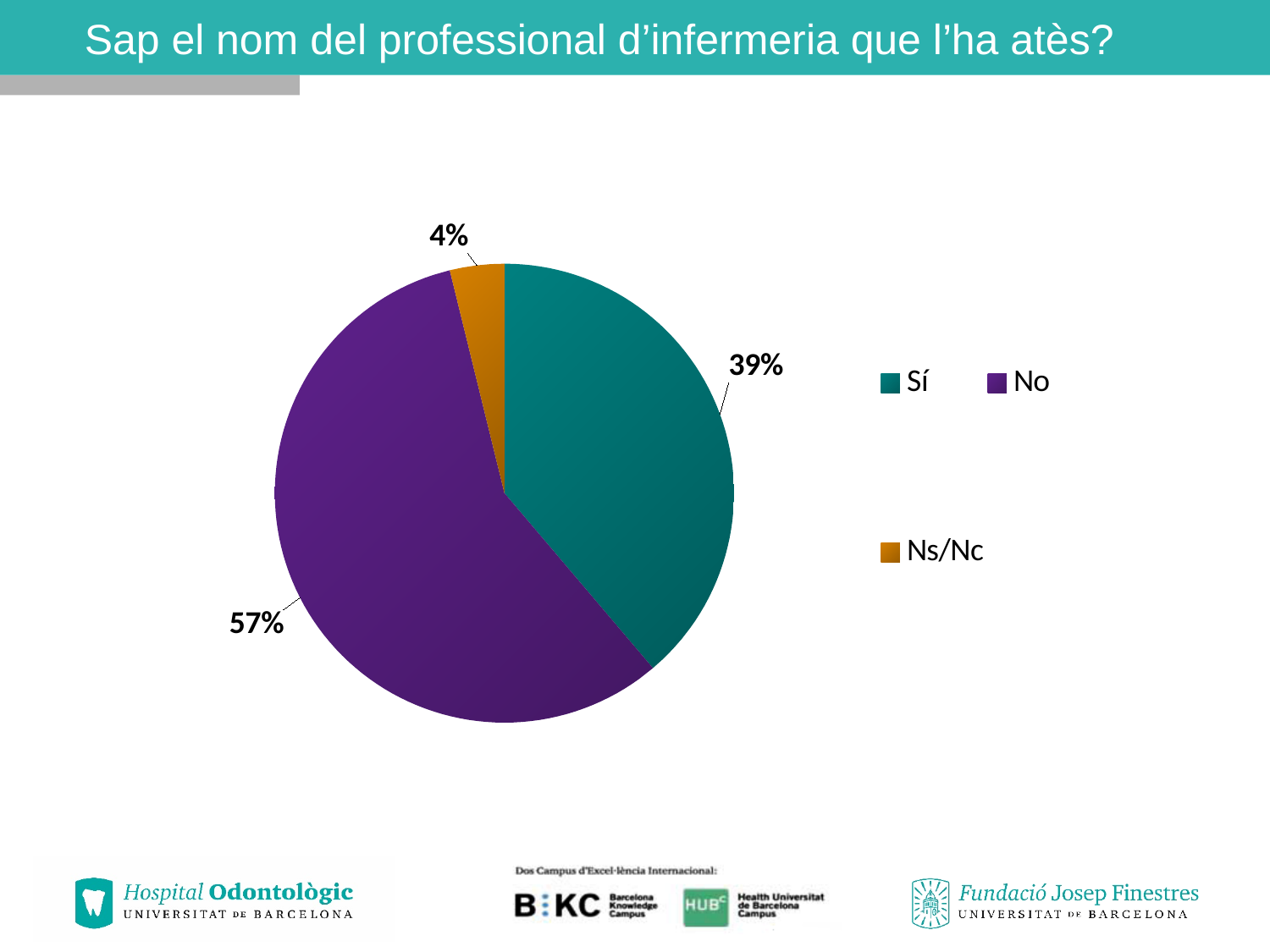
Which is larger, the share for "Sí" or the share for "No"? No What percentage of respondents answered "No"? 57% What colour is the "Ns/Nc" slice? orange What percentage of respondents answered "Ns/Nc"? 4% How many entries does the legend list? 3 What is the title of the slide containing the chart? Sap el nom del professional d'infermeria que l'ha atès? How many categories does the pie chart have? 3 What is the difference in percentage points between "No" and "Sí"? 18 What percentage of respondents answered "Sí"? 39% What kind of chart is shown on the slide? pie chart Which category has the smallest share of the pie? Ns/Nc Which category has the largest share of the pie? No